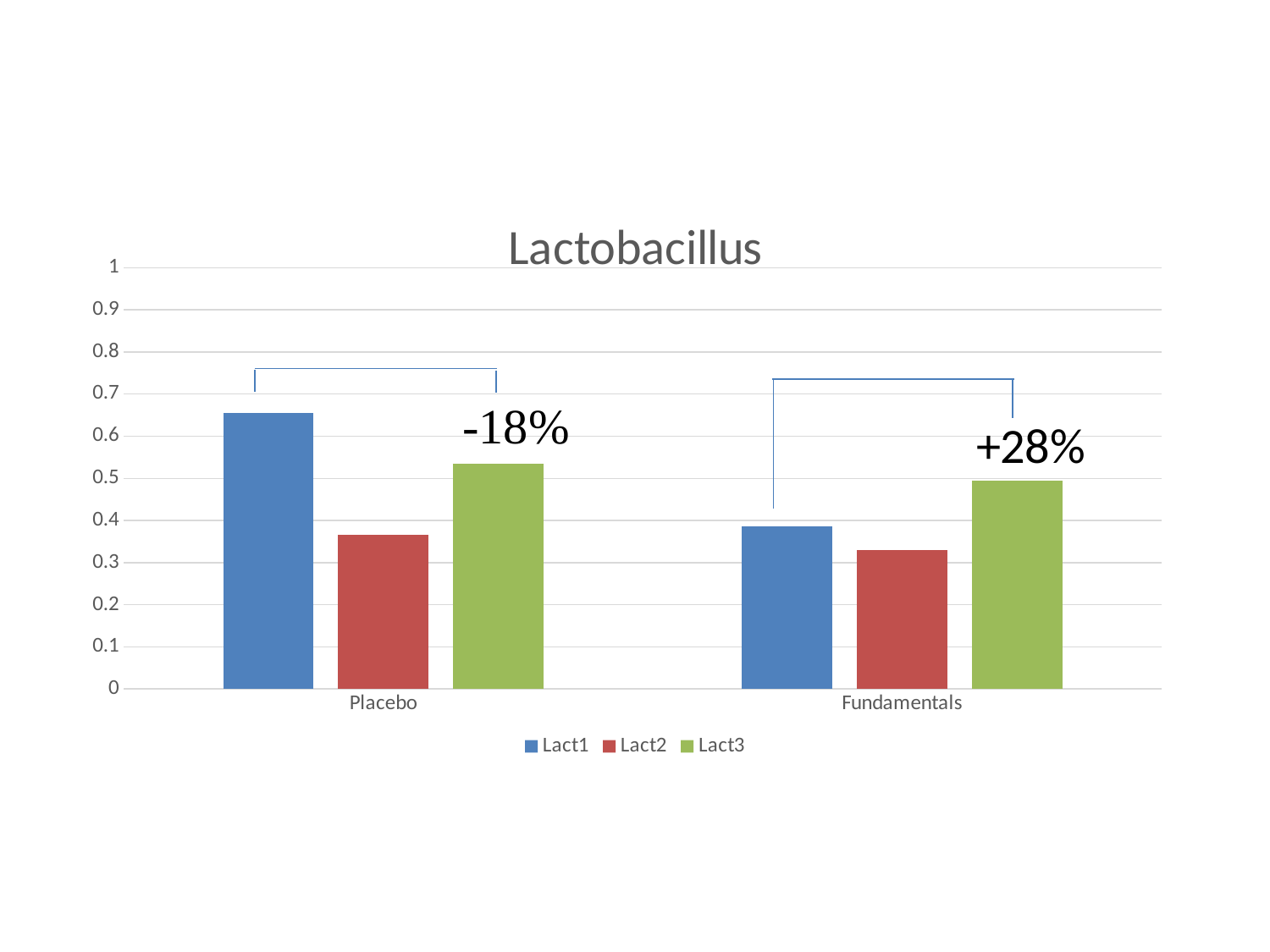
How many series does the legend list? 3 What percentage change is annotated above the Fundamentals group? +28% Which series has the highest bar in the Fundamentals group? Lact3 What is the title of the chart? Lactobacillus How many categories are shown on the x axis? 2 Which is larger: Lact1 for Placebo or Lact1 for Fundamentals? Lact1 for Placebo Is the Lact1 bar for Placebo greater or less than 0.6? greater What kind of chart is shown on the slide? bar chart Which series has the lowest bar in the Fundamentals group? Lact2 Which series has the highest bar in the Placebo group? Lact1 Which is larger: Lact3 for Placebo or Lact2 for Placebo? Lact3 for Placebo Is the Lact2 bar for Fundamentals greater or less than 0.4? less